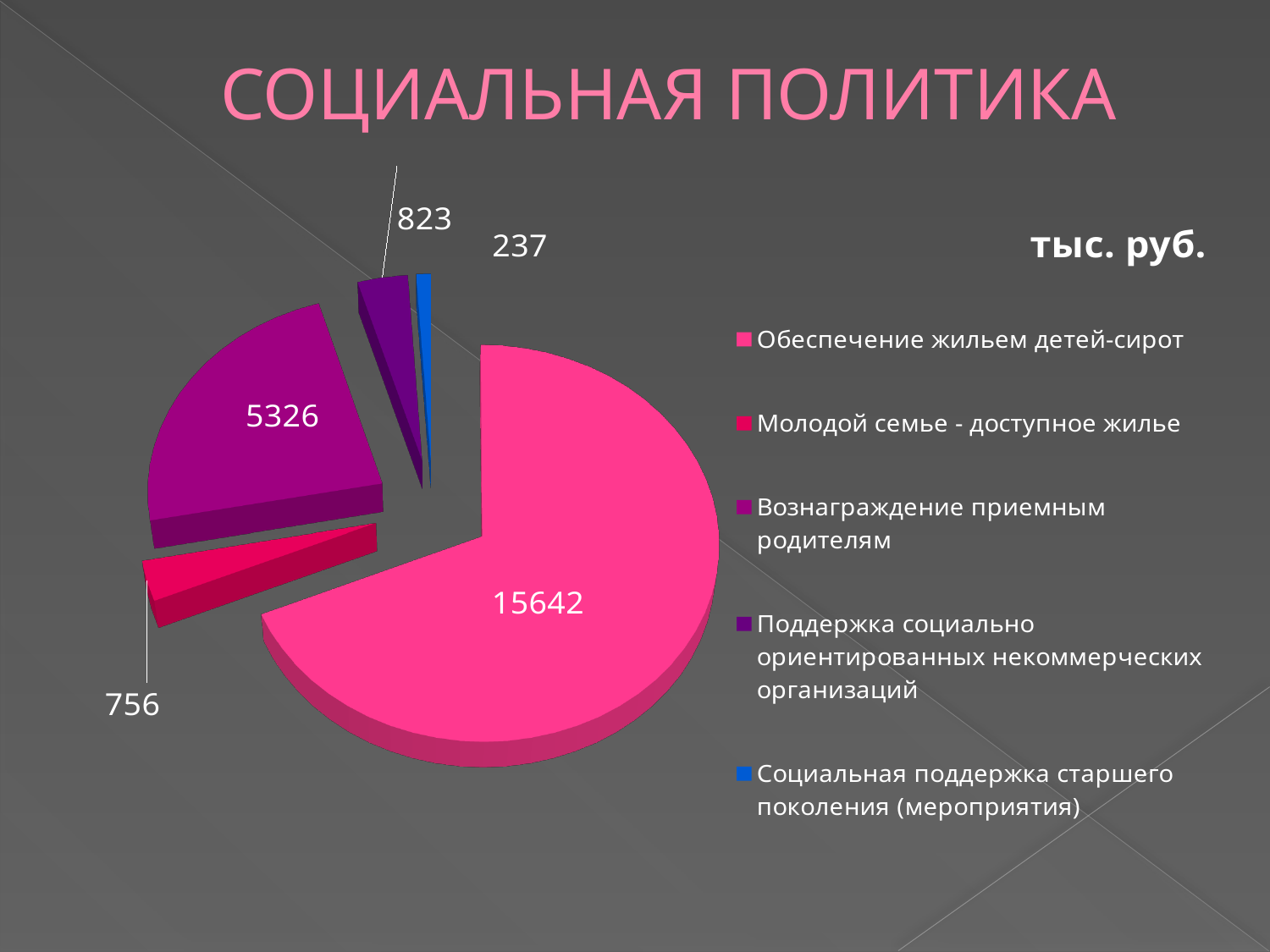
What is the value for Вознаграждение приемным родителям? 5326 What is the value for Поддержка социально ориентированных некоммерческих организаций? 823 Which category has the smallest slice of the pie? Социальная поддержка старшего поколения (мероприятия) Which is larger: the value for Поддержка социально ориентированных некоммерческих организаций or the value for Молодой семье - доступное жилье? Поддержка социально ориентированных некоммерческих организаций What is the value for Молодой семье - доступное жилье? 756 What is the value for Социальная поддержка старшего поколения (мероприятия)? 237 How many categories does the legend list? 5 What is the difference between the values for Обеспечение жильем детей-сирот and Вознаграждение приемным родителям? 10316 What is the value for Обеспечение жильем детей-сирот? 15642 What unit is indicated next to the chart? тыс. руб. Which category has the largest slice of the pie? Обеспечение жильем детей-сирот What type of chart is shown on the slide? pie chart